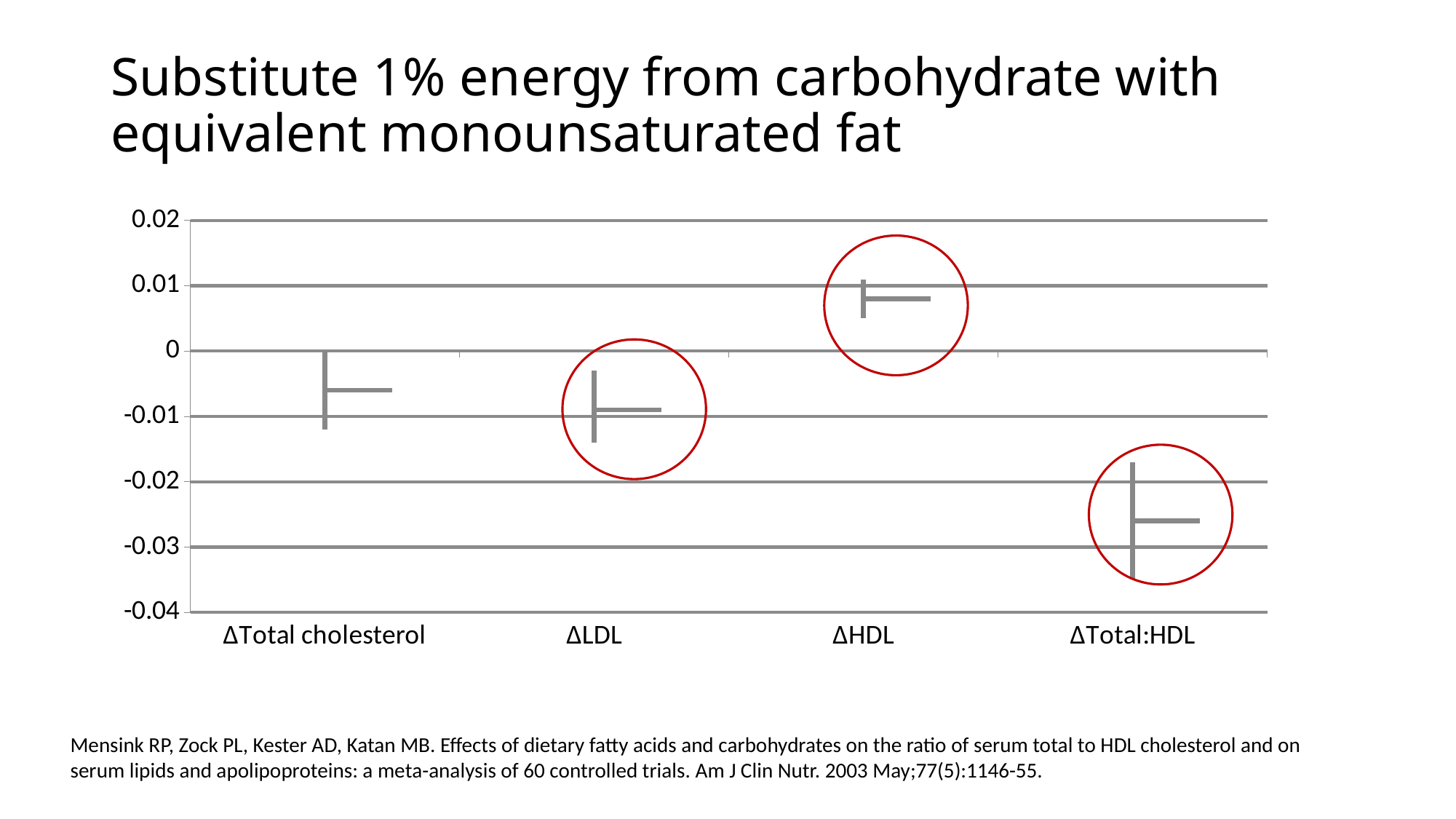
Which category has the lowest plotted value? ΔTotal:HDL Is the value for ΔTotal cholesterol greater or less than -0.01? greater Which is larger, the value for ΔHDL or the value for ΔLDL? ΔHDL How many categories are plotted on the x axis of the chart? 4 Which is larger, the value for ΔTotal cholesterol or the value for ΔTotal:HDL? ΔTotal cholesterol What is the title of the slide containing the chart? Substitute 1% energy from carbohydrate with equivalent monounsaturated fat Is the value for ΔHDL greater or less than 0.01? less Is the value for ΔHDL greater or less than 0? greater Which category has the highest plotted value? ΔHDL Which category on the chart is not highlighted with a red circle? ΔTotal cholesterol